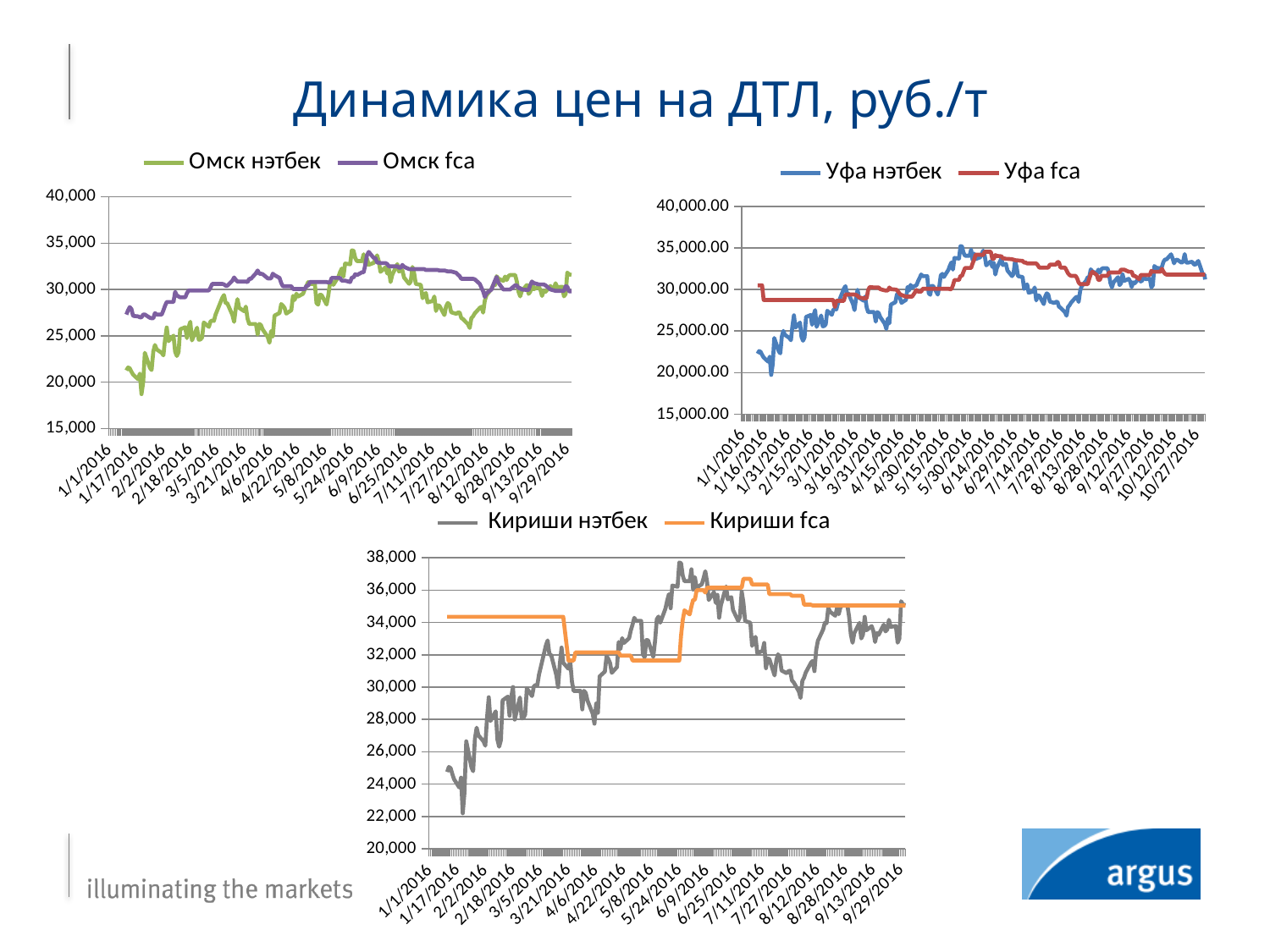
In the top-left chart (Омск), is the value for Омск нэтбек at the start of the series (January 2016) greater or less than 25,000? less In the top-right chart (Уфа), is the value for Уфа fca around 6/14/2016 greater or less than 30,000.00? greater How many series does the legend of the top-left chart (Омск) list? 2 In the bottom chart (Кириши), is the lowest point of Кириши нэтбек greater or less than 24,000? less What kind of chart is the top-left chart (Омск)? line chart What is the title of the slide? Динамика цен на ДТЛ, руб./т What are the two legend entries of the bottom chart (Кириши)? Кириши нэтбек and Кириши fca In the top-left chart (Омск), does Омск нэтбек generally rise or fall from January 2016 to June 2016? rise In the bottom chart (Кириши), does Кириши нэтбек generally rise or fall from January 2016 to late May 2016? rise How many series does the legend of the top-right chart (Уфа) list? 2